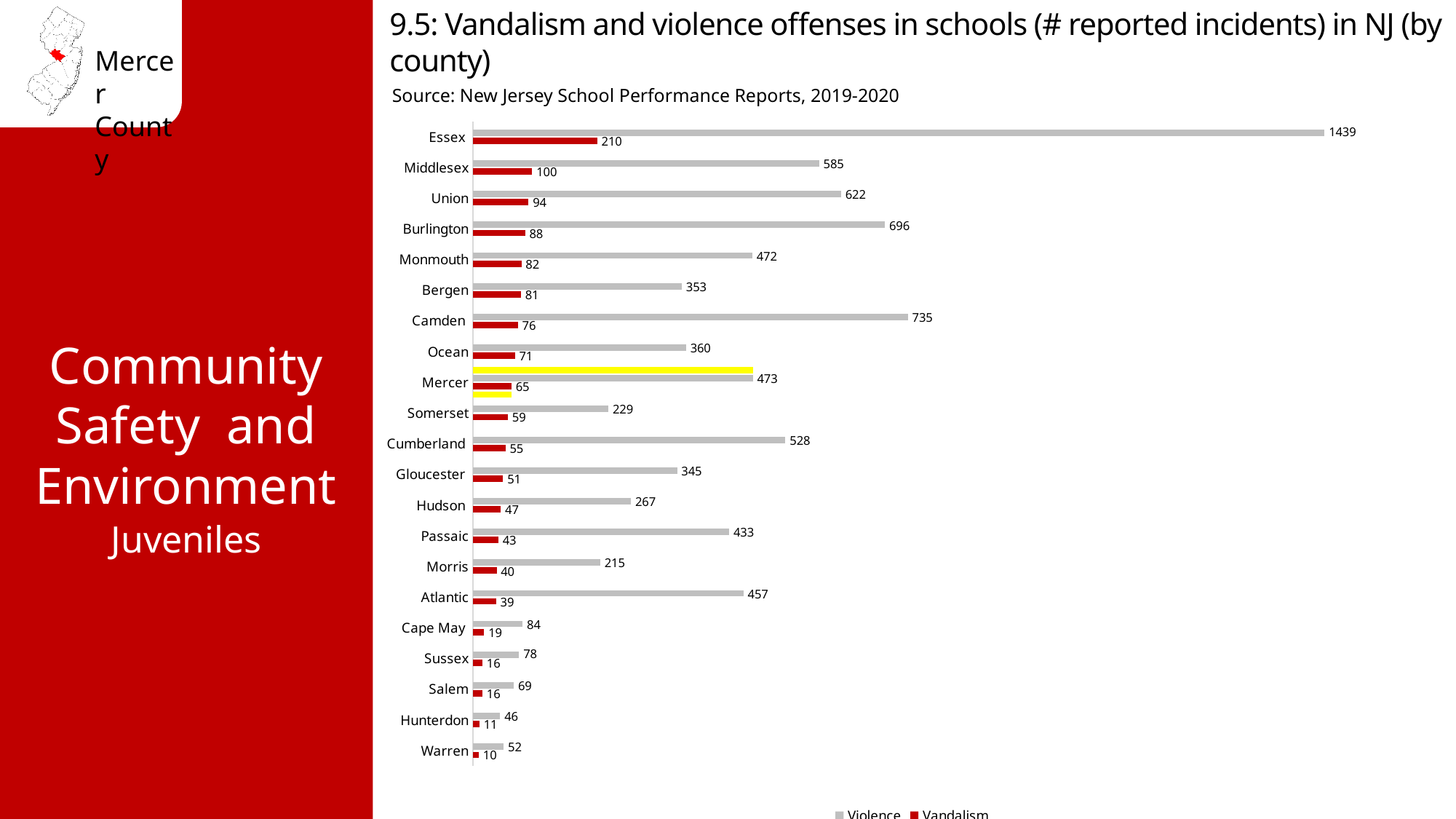
Which county has the lowest number of reported Violence incidents? Hunterdon Which county has the lowest number of reported Vandalism incidents? Warren How many counties are shown in the chart? 21 Which county has the highest number of reported Violence incidents? Essex What is the difference between the Violence and Vandalism incident counts for Mercer? 408 What kind of chart is shown on the slide? Bar chart How many series does the legend list? 2 Which series is shown in red in the chart? Vandalism What is the number of reported Vandalism incidents in Mercer? 65 Which county has more reported Violence incidents, Burlington or Union? Burlington What is the number of reported Violence incidents in Camden? 735 What is the number of reported Violence incidents in Essex? 1439